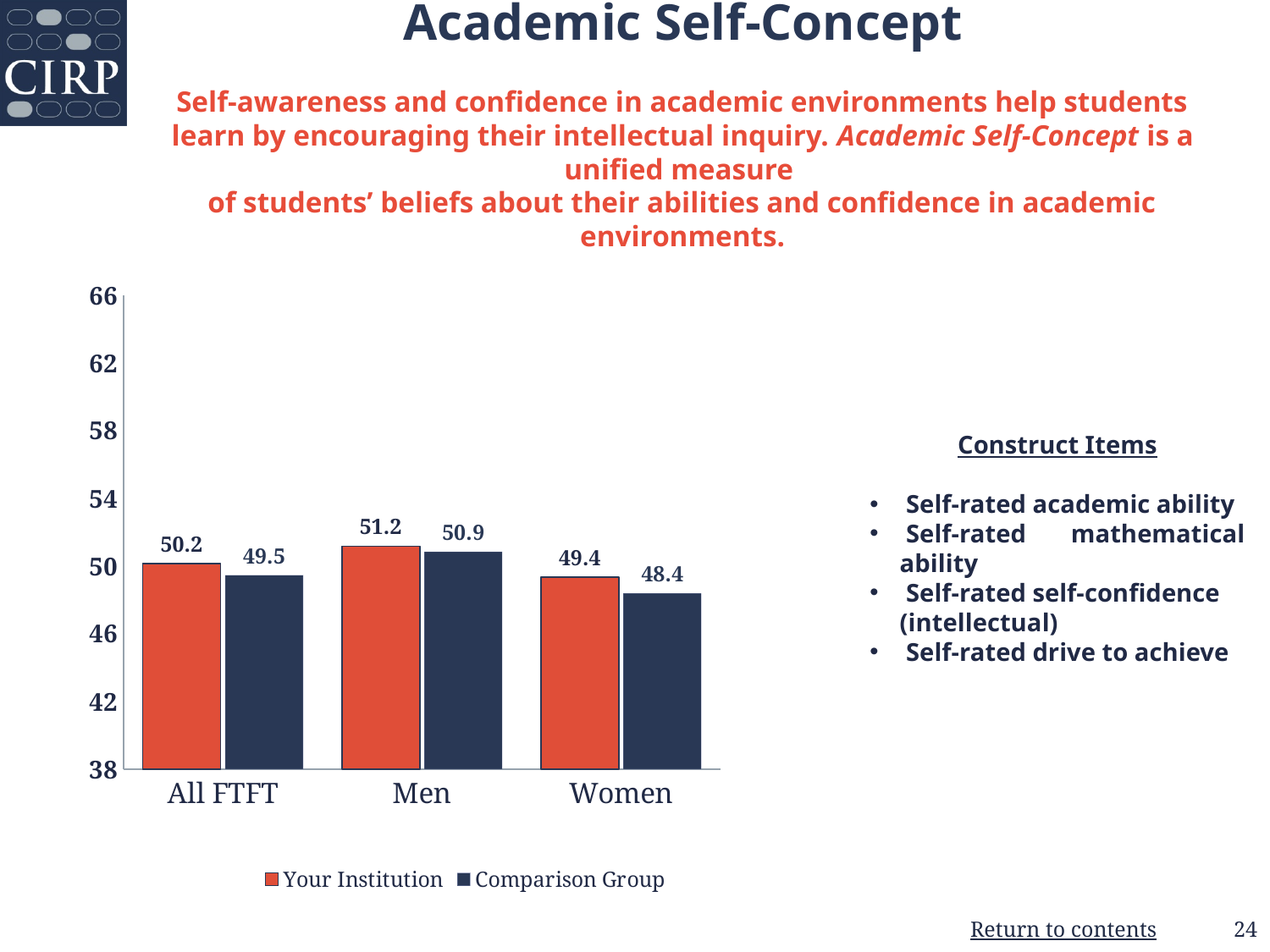
How many series does the legend list? 2 Which category has the lowest Your Institution value? Women What is the Your Institution value for All FTFT? 50.2 Which is larger for All FTFT: Your Institution or Comparison Group? Your Institution What is the Your Institution value for Men? 51.2 What kind of chart is shown on the slide? bar chart How many categories are shown on the x axis? 3 Which category has the highest Comparison Group value? Men What is the Comparison Group value for Women? 48.4 What is the difference between the Your Institution values for Men and Women? 1.8 What is the difference between the Your Institution and Comparison Group values for Women? 1.0 Is the Comparison Group value for Women greater or less than 50? less